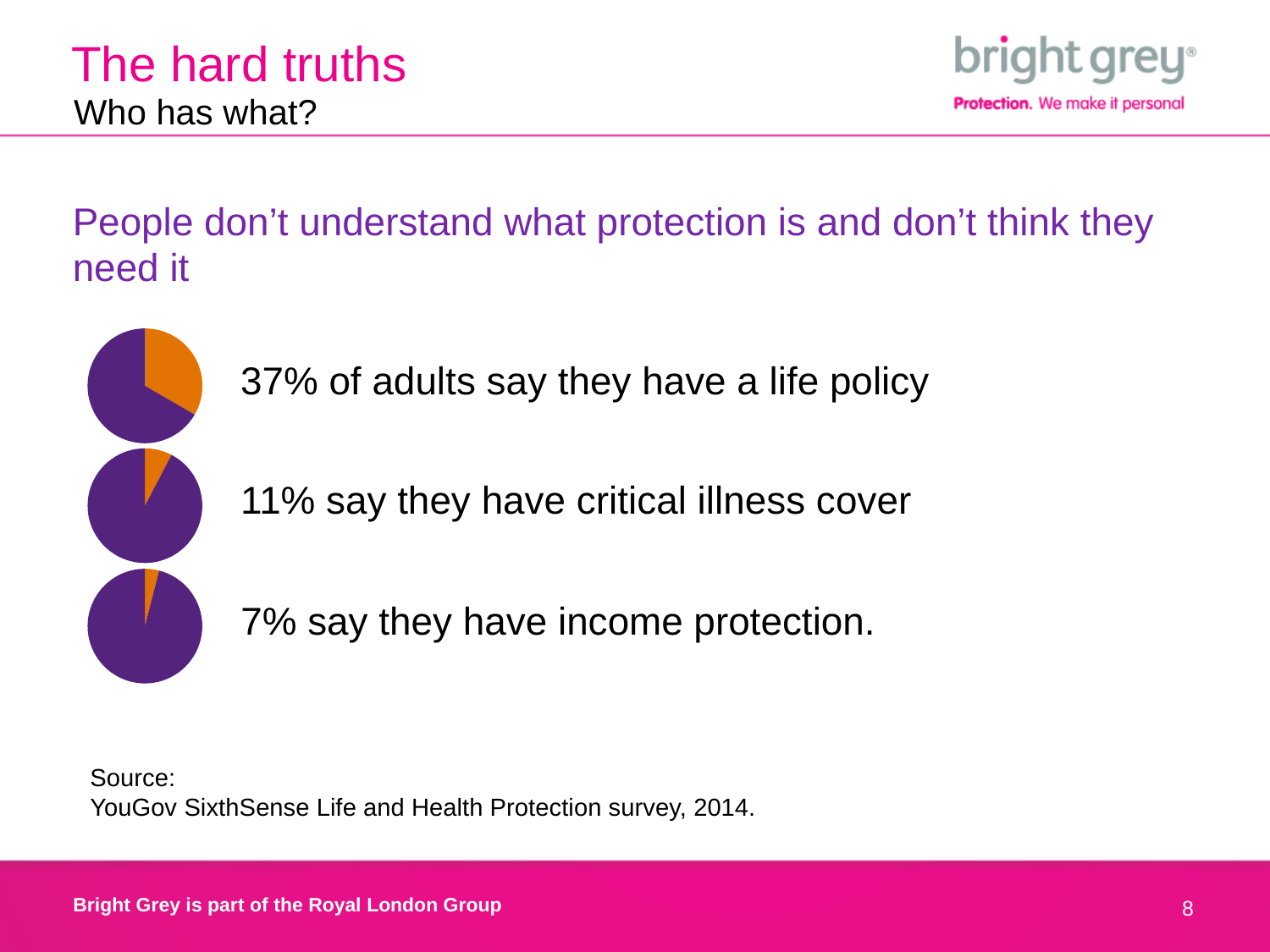
What is the difference between the share of adults with a life policy and the share with critical illness cover? 26% What colour is the slice representing the people who have each type of cover in the pie charts? Orange In the middle pie chart, what percentage say they have critical illness cover? 11% What is the difference between the share with critical illness cover and the share with income protection? 4% Which of the three pie charts shows the largest highlighted share? Life policy (37%) Which of the three pie charts shows the smallest highlighted share? Income protection (7%) In the top pie chart, what percentage of adults say they have a life policy? 37% In the bottom pie chart, what percentage say they have income protection? 7% What kind of chart is used to show the share of adults with a life policy? Pie chart How many pie charts are shown on the slide? 3 In the top pie chart, what share of the pie is taken by the orange slice? 37% Which is larger: the share with a life policy or the share with income protection? Life policy